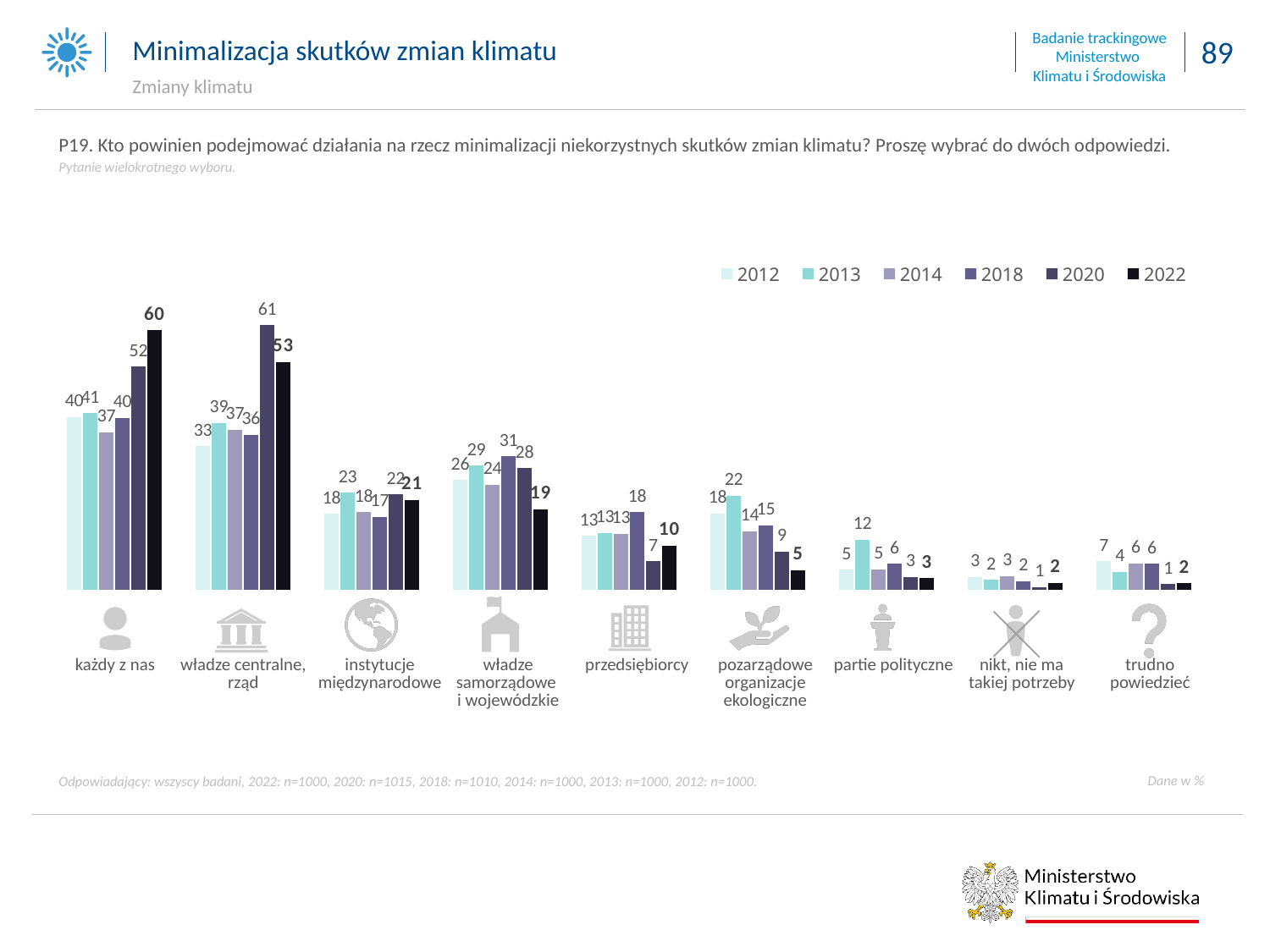
How many series does the legend list? 6 What kind of chart is shown on the slide? bar chart Which years are listed in the legend? 2012, 2013, 2014, 2018, 2020, 2022 How many categories are shown on the x axis? 9 What is the 2013 value for "pozarządowe organizacje ekologiczne"? 22 Which category has the highest 2022 value? każdy z nas What is the difference between the 2022 and 2020 values for "każdy z nas"? 8 Which is larger for "władze samorządowe i wojewódzkie": the 2018 value or the 2022 value? 2018 What is the 2018 value for "przedsiębiorcy"? 18 What is the 2020 value for "władze centralne, rząd"? 61 What is the 2022 value for "każdy z nas"? 60 Which category has the lowest 2020 value? nikt, nie ma takiej potrzeby and trudno powiedzieć (both 1)